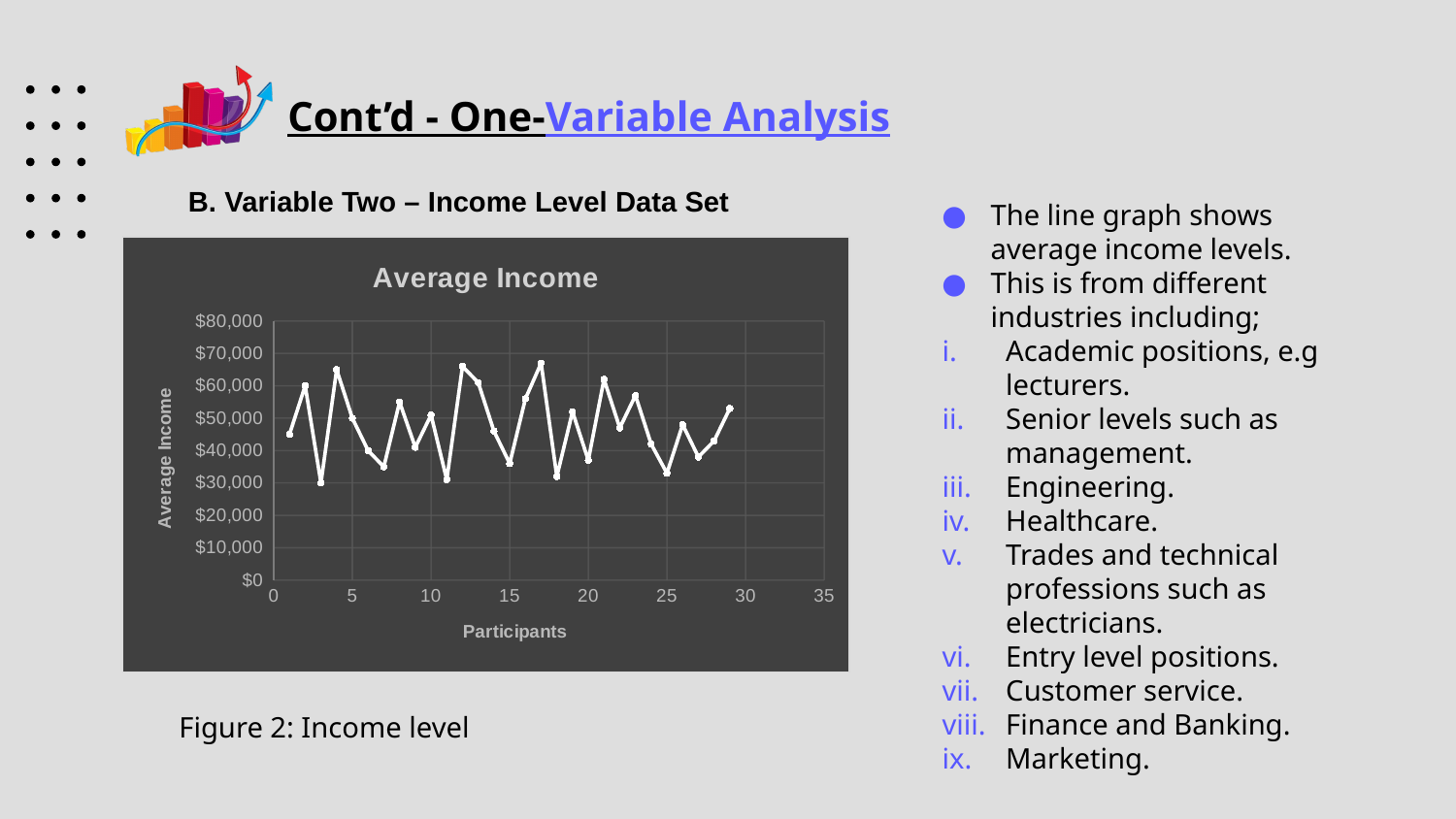
Is the value for participant 11 greater or less than $40,000? less Is the value for participant 3 greater or less than $40,000? less Is the value for participant 12 greater or less than $60,000? greater Which has the higher average income, participant 12 or participant 15? Participant 12 What kind of chart is shown on the slide? Line chart What is the title of the chart? Average Income Which has the higher average income, participant 3 or participant 4? Participant 4 Does the line rise or fall from participant 3 to participant 4? Rises What is the label of the x axis of the chart? Participants